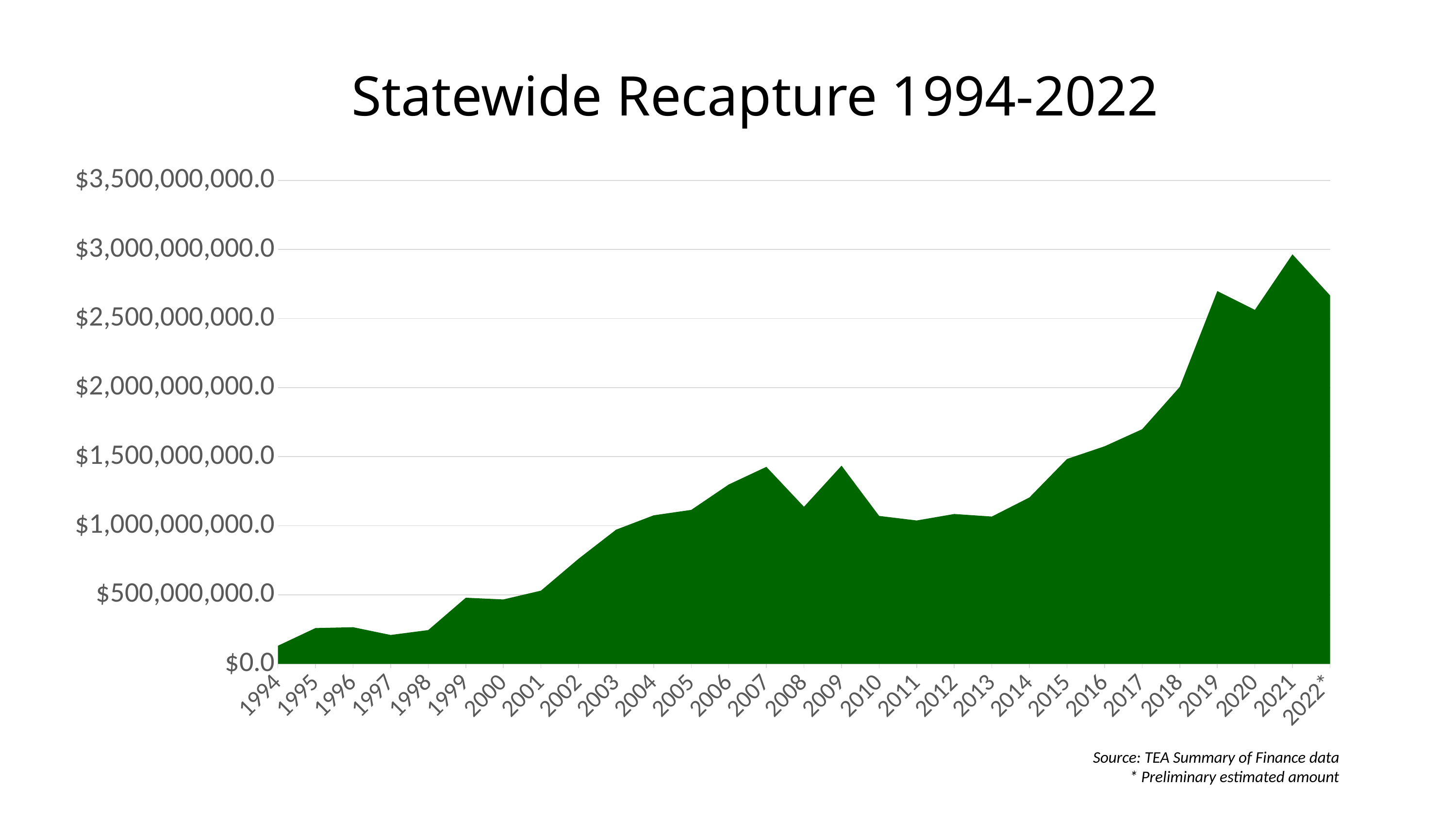
How many years are plotted along the x axis? 29 Is the value for 2017 greater or less than $1,500,000,000.0? greater Which year has the larger value, 2015 or 2017? 2017 Which year has the larger value, 2019 or 2021? 2021 Which year has the lowest statewide recapture value? 1994 Which year has the highest statewide recapture value? 2021 Overall, do the values rise or fall from 1994 to 2022? Rise What is the title of the chart? Statewide Recapture 1994-2022 Is the value for 2021 greater or less than $2,500,000,000.0? greater Is the value for 2007 greater or less than $1,000,000,000.0? greater What kind of chart is shown on the slide? Area chart